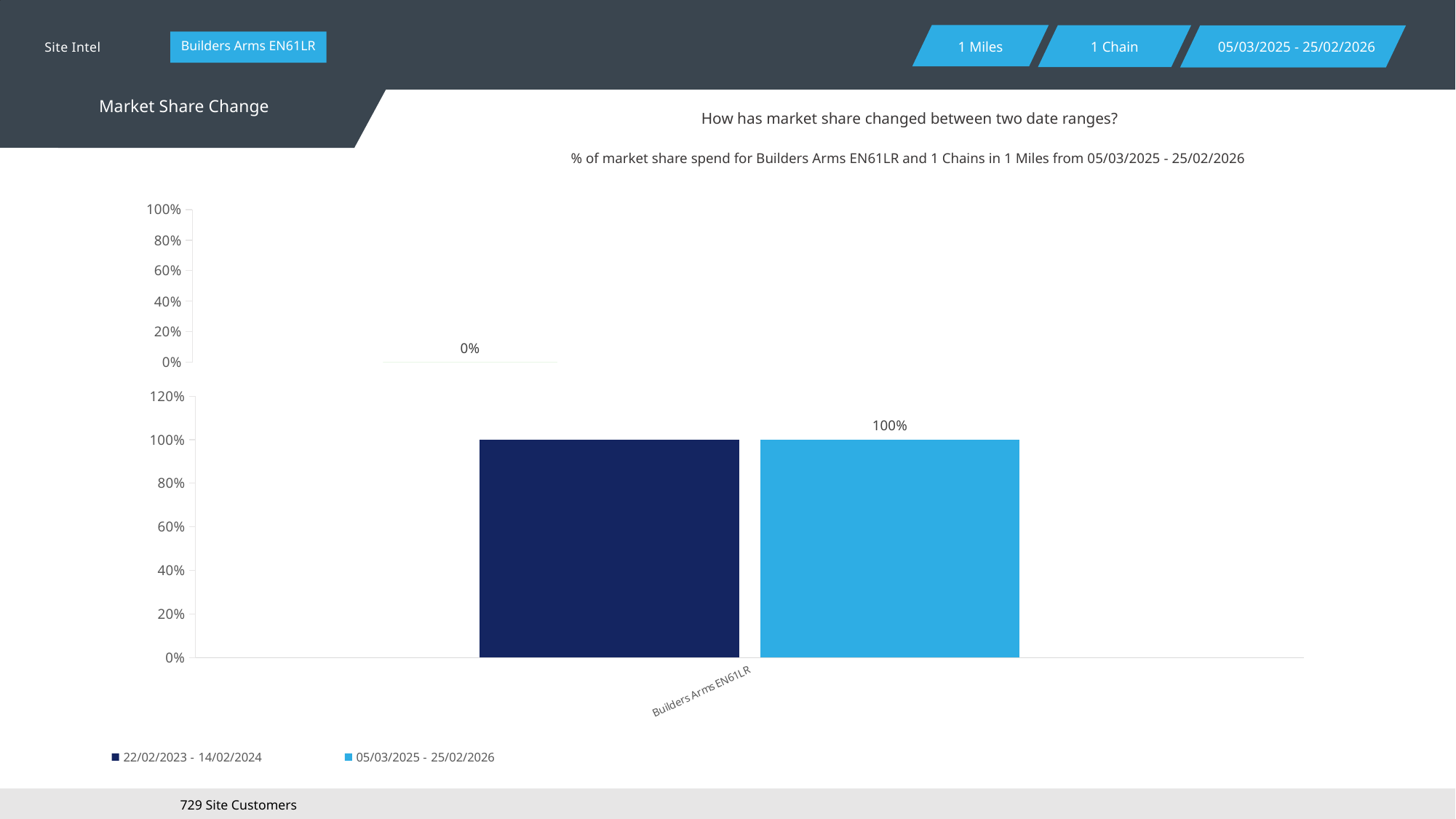
In the bottom chart, what is the value for Builders Arms EN61LR in the 05/03/2025 - 25/02/2026 series? 100% In the bottom chart, how many categories are shown on the x axis? 1 In the bottom chart, how many series does the legend list? 2 In the upper chart, what value does the single data label show? 0% In the bottom chart, what kind of chart is shown? bar chart In the bottom chart, what is the difference between the 05/03/2025 - 25/02/2026 value and the 22/02/2023 - 14/02/2024 value for Builders Arms EN61LR? 0% In the bottom chart, what is the value for Builders Arms EN61LR in the 22/02/2023 - 14/02/2024 series? 100% In the bottom chart, what is the category label on the x axis? Builders Arms EN61LR In the bottom chart, what colour represents the 05/03/2025 - 25/02/2026 series? light blue In the bottom chart, is the value for the 22/02/2023 - 14/02/2024 series greater or less than 80%? greater